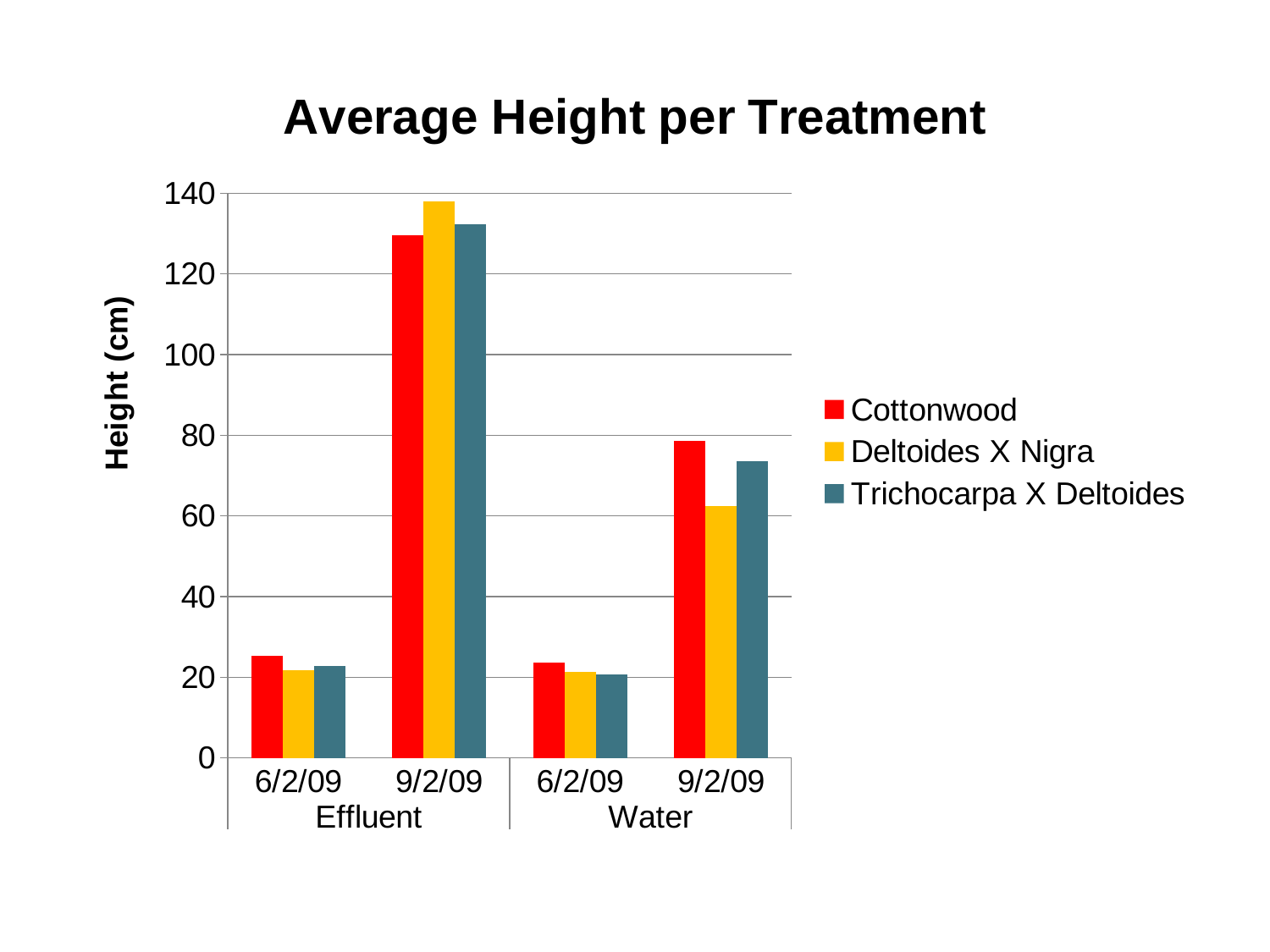
Which series has the shortest bar for 9/2/09 under the Water treatment? Deltoides X Nigra Is the Cottonwood value for 9/2/09 under Effluent greater or less than 120? greater How many series does the legend list? 3 Which series has the tallest bar for 9/2/09 under the Water treatment? Cottonwood Which is larger: the Cottonwood value for 9/2/09 under Effluent or the Cottonwood value for 9/2/09 under Water? Effluent What kind of chart is shown on the slide? bar chart Is the Trichocarpa X Deltoides value for 9/2/09 under Water greater or less than 60? greater What is the label on the vertical axis of the chart? Height (cm) Under the Effluent treatment, do the Cottonwood values rise or fall from 6/2/09 to 9/2/09? rise How many groups of bars are plotted along the x axis? 4 Which series has the tallest bar for 9/2/09 under the Effluent treatment? Deltoides X Nigra Is the Deltoides X Nigra value for 9/2/09 under Water greater or less than 80? less